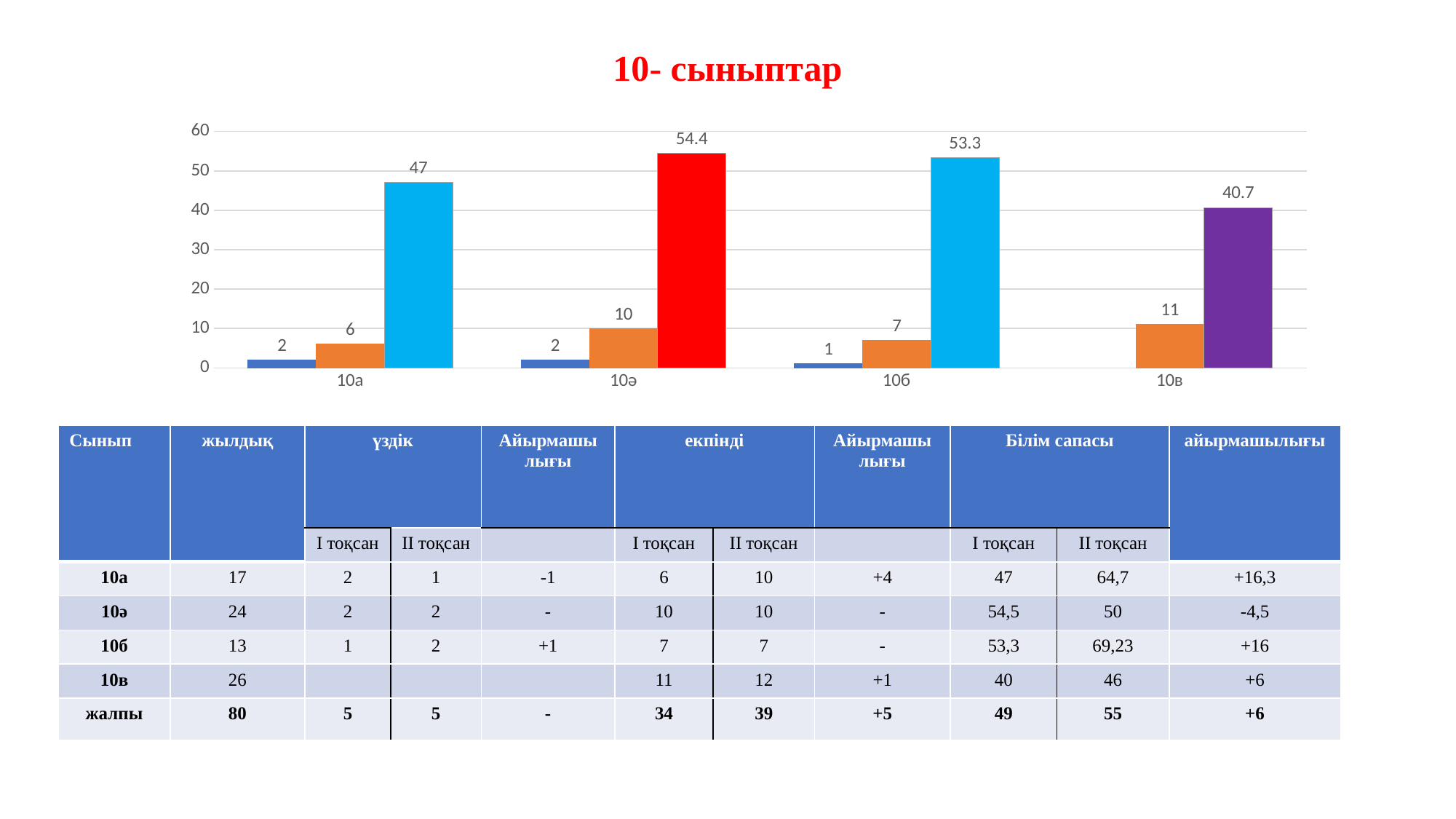
Which category has the lowest tallest bar in the chart? 10в Is the value of the tallest bar for 10в greater or less than 50? less What is the difference between the tallest bar for 10ә (54.4) and the tallest bar for 10а (47)? 7.4 What is the value of the purple bar for 10в in the chart? 40.7 Is the orange bar for 10ә larger or smaller than the orange bar for 10б? larger What is the value of the tallest bar for 10ә in the chart? 54.4 What type of chart is shown on the slide? bar chart What is the value of the tallest bar for 10б in the chart? 53.3 Which category has the highest tallest bar in the chart? 10ә How many categories are shown on the x axis of the chart? 4 What is the value of the orange bar for 10в in the chart? 11 What is the value of the orange bar for 10а in the chart? 6